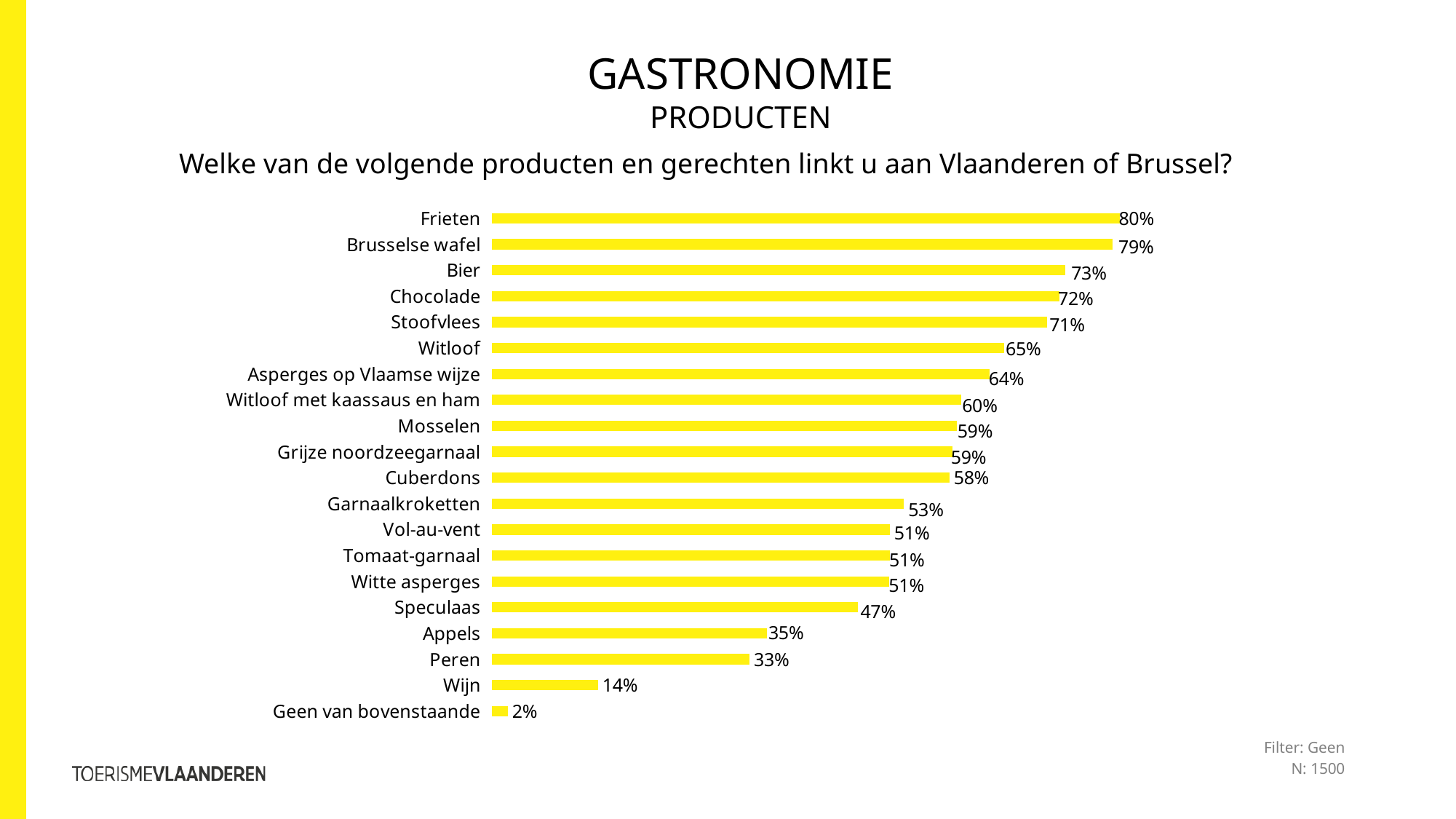
What is the value for Frieten? 80% What is the value for Stoofvlees? 71% What question is the chart answering, as stated on the slide? Welke van de volgende producten en gerechten linkt u aan Vlaanderen of Brussel? What is the difference between the values for Appels and Peren? 2% What is the value for Wijn? 14% How many categories are shown in the chart? 20 Which category has the highest value? Frieten Which is larger, the value for Witloof or the value for Mosselen? Witloof What kind of chart is shown on the slide? Bar chart Which category has the lowest value? Geen van bovenstaande What is the difference between the values for Bier and Chocolade? 1% What is the value for Speculaas? 47%